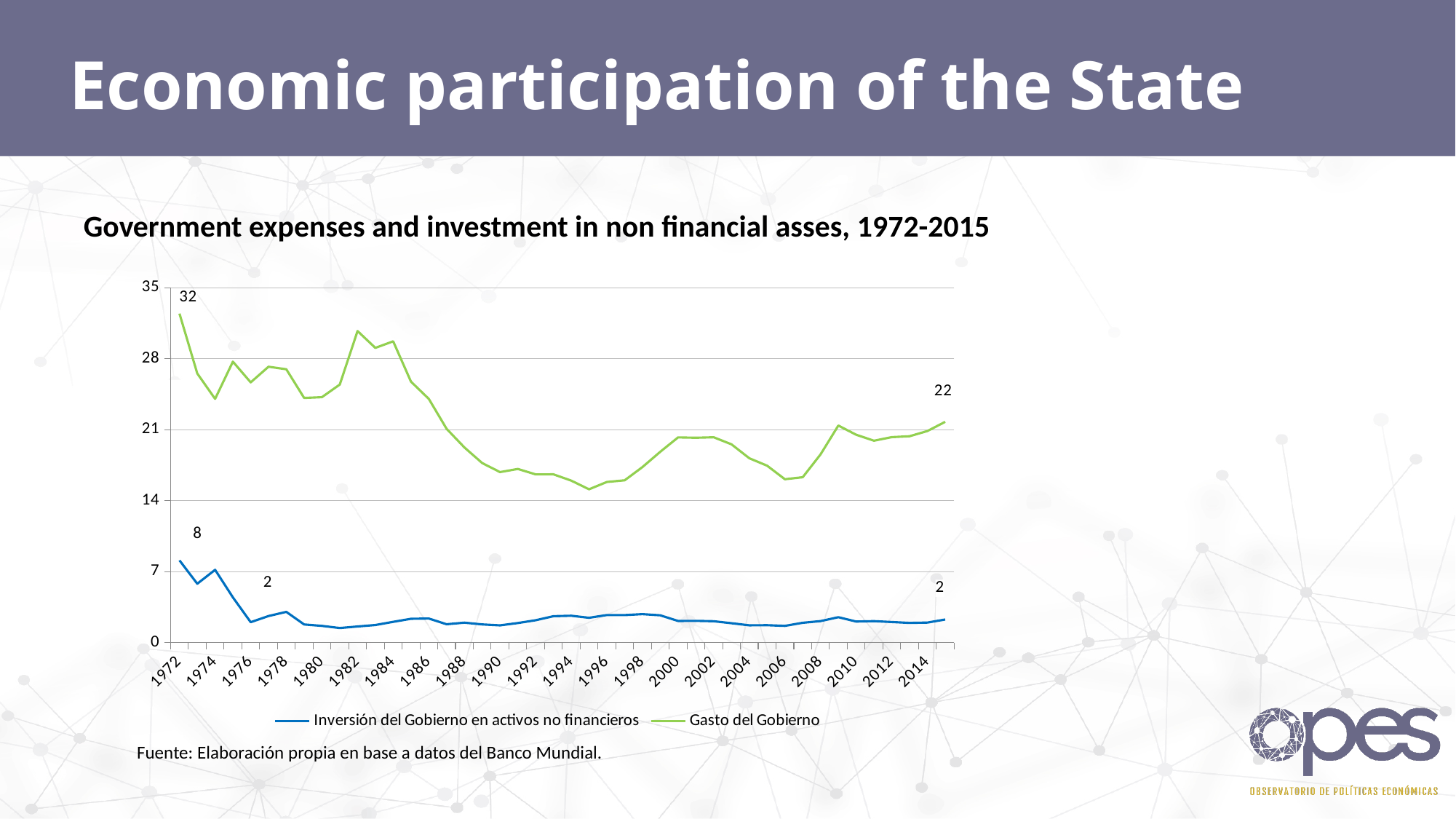
What type of chart is shown on the slide? line chart What is the title of the chart? Government expenses and investment in non financial asses, 1972-2015 In which year does Inversión del Gobierno en activos no financieros reach its highest value? 1972 What is the value of Gasto del Gobierno in 1972? 32 By how much did Gasto del Gobierno fall between 1972 and 2015? 10 How many series does the legend list? 2 Is the value of Gasto del Gobierno in 1996 greater or less than 21? less What is the value of Inversión del Gobierno en activos no financieros in 1972? 8 What is the difference between Inversión del Gobierno en activos no financieros in 1972 and in 2015? 6 What is the value of Gasto del Gobierno in 2015? 22 What is the value of Inversión del Gobierno en activos no financieros in 2015? 2 In 1972, which series has the larger value, Gasto del Gobierno or Inversión del Gobierno en activos no financieros? Gasto del Gobierno